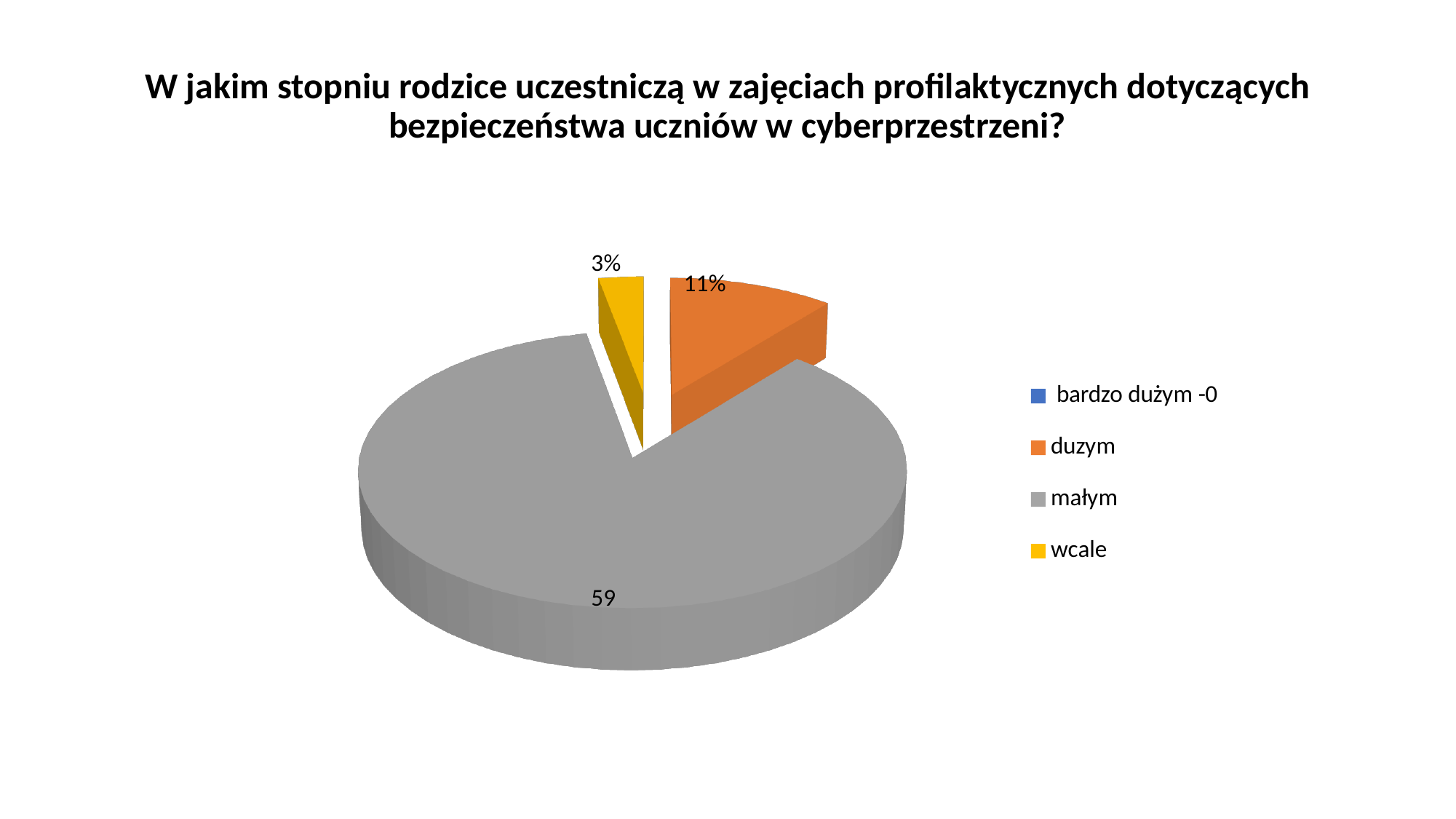
How many slices are visible in the pie? 3 What is the first entry listed in the legend? bardzo dużym -0 What value is shown for the małym slice? 59 What is the difference between the duzym and wcale percentages? 8% What percentage is shown for the wcale slice? 3% What colour is the małym slice? gray How many entries does the legend list? 4 Which slice is larger, duzym or wcale? duzym Which of the visible slices is the smallest? wcale What type of chart is shown on the slide? pie chart Which category has the largest slice of the pie? małym What percentage is shown for the duzym slice? 11%